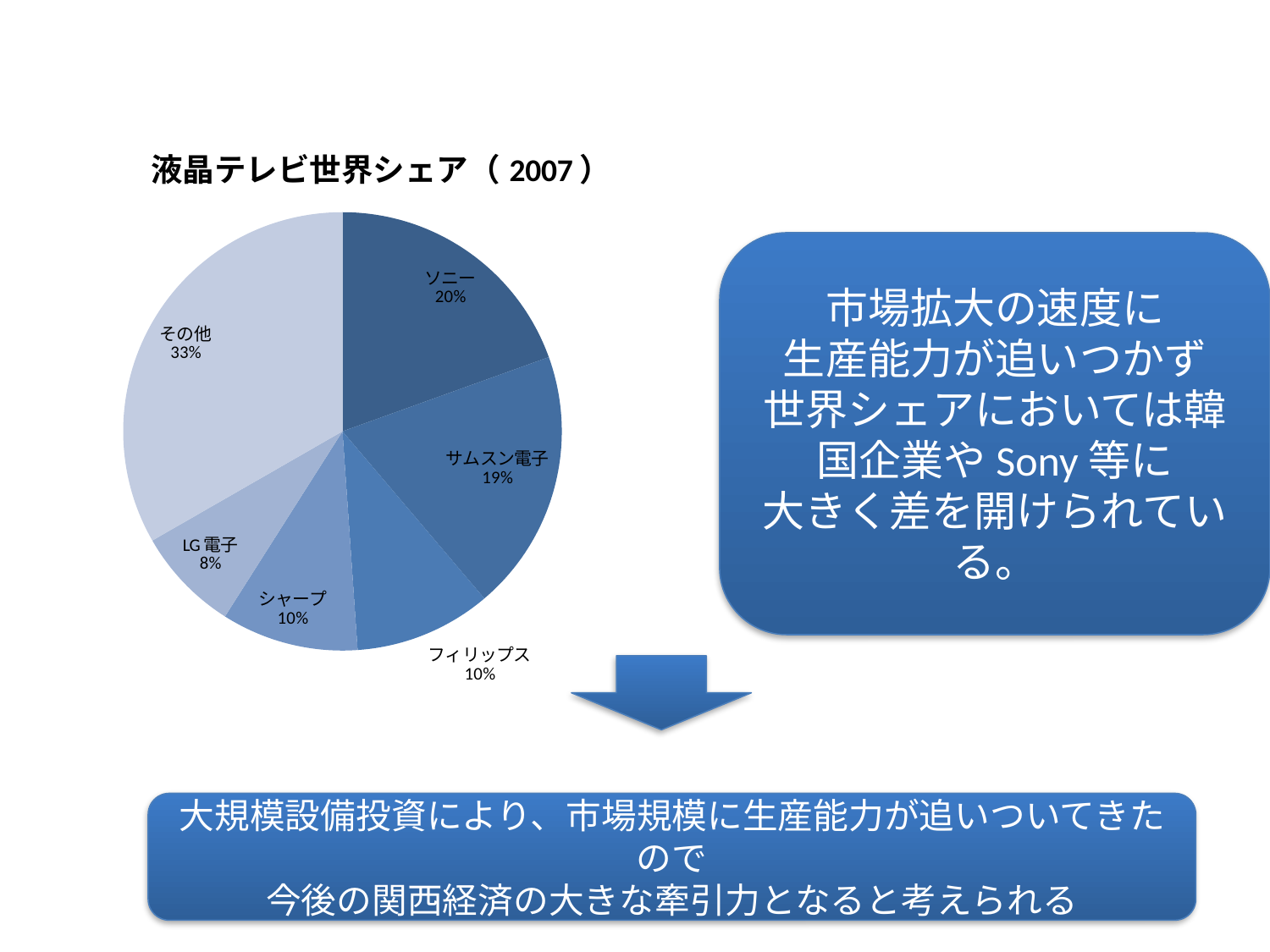
Which slice of the pie chart is the largest? その他 What share does LG 電子 hold in the pie chart? 8% Which has the larger share, ソニー or サムスン電子? ソニー What is the combined share of シャープ and フィリップス? 20% What is the title of the chart? 液晶テレビ世界シェア（2007） What share does ソニー hold in the pie chart? 20% Which slice of the pie chart is the smallest? LG 電子 What share does シャープ hold in the pie chart? 10% What kind of chart is shown on the slide? Pie chart What share does サムスン電子 hold in the pie chart? 19% How many slices does the pie chart have? 6 By how many percentage points does ソニー's share exceed サムスン電子's share? 1 percentage point